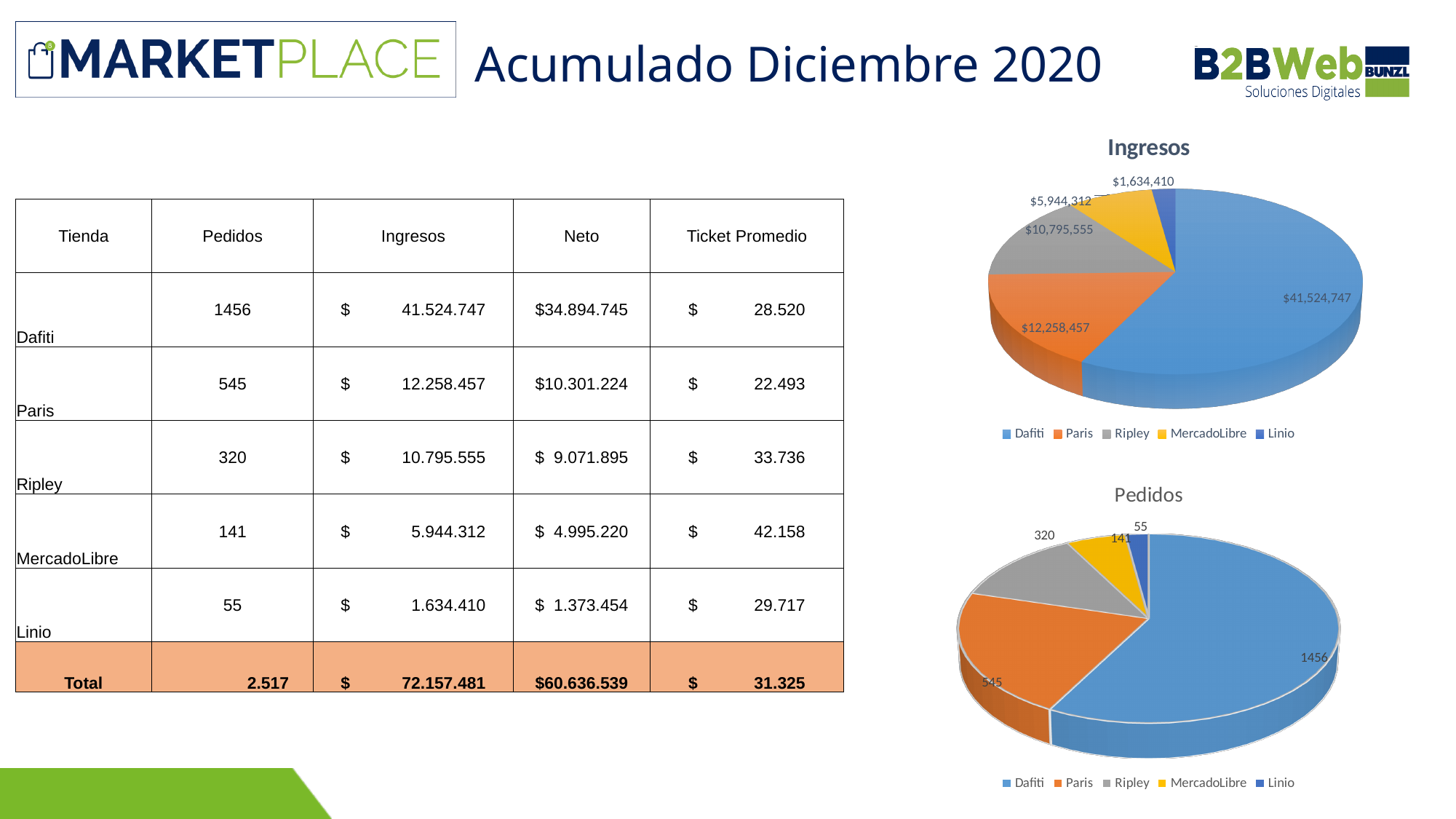
What type of chart is the 'Ingresos' chart? pie chart In the 'Ingresos' chart, what is the value for Dafiti? $41,524,747 In the 'Pedidos' chart, what colour is the Paris slice? orange In the 'Pedidos' chart, what is the value for Ripley? 320 In the 'Pedidos' chart, what is the value for Linio? 55 In the 'Ingresos' chart, what is the value for MercadoLibre? $5,944,312 In the 'Pedidos' chart, what is the difference between Dafiti and Paris? 911 In the 'Ingresos' chart, how many stores does the legend list? 5 In the 'Ingresos' chart, which store has the smallest slice? Linio In the 'Pedidos' chart, which is larger, Paris or MercadoLibre? Paris In the 'Ingresos' chart, what is the difference between Paris and Ripley? $1,462,902 In the 'Pedidos' chart, which store has the largest slice? Dafiti